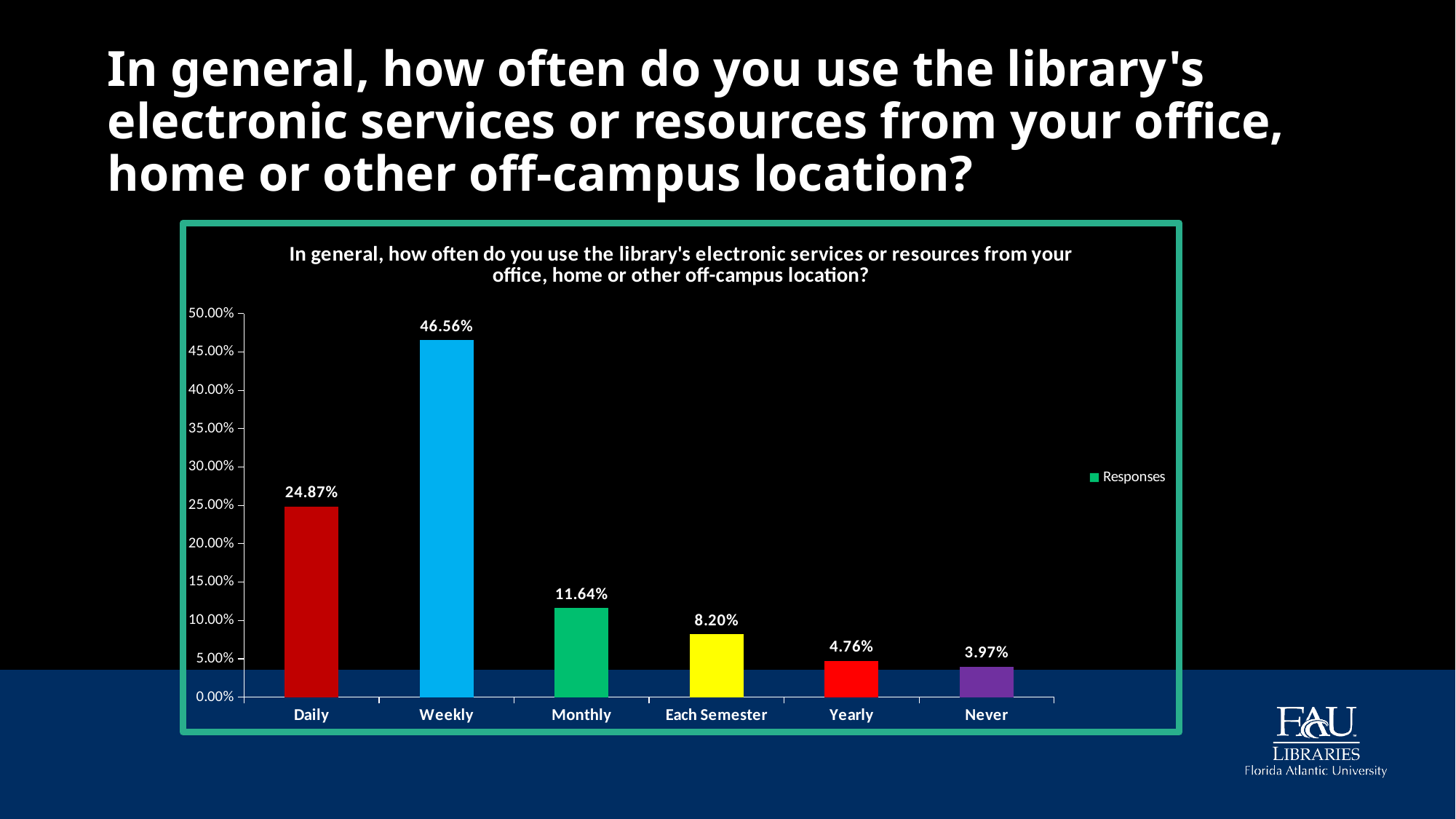
Is the value for Daily greater or less than 20.00%? greater Which category has the lowest value? Never What is the value for Never? 3.97% What percentage of responses is shown for Weekly? 46.56% What series name is listed in the legend? Responses What is the difference between the Weekly and Daily values? 21.69% What is the difference between the Monthly and Yearly values? 6.88% What is the value for Each Semester? 8.20% Which category has the highest value? Weekly What type of chart is shown on the slide? bar chart Which is larger, the value for Daily or the value for Monthly? Daily How many categories are shown on the x axis? 6